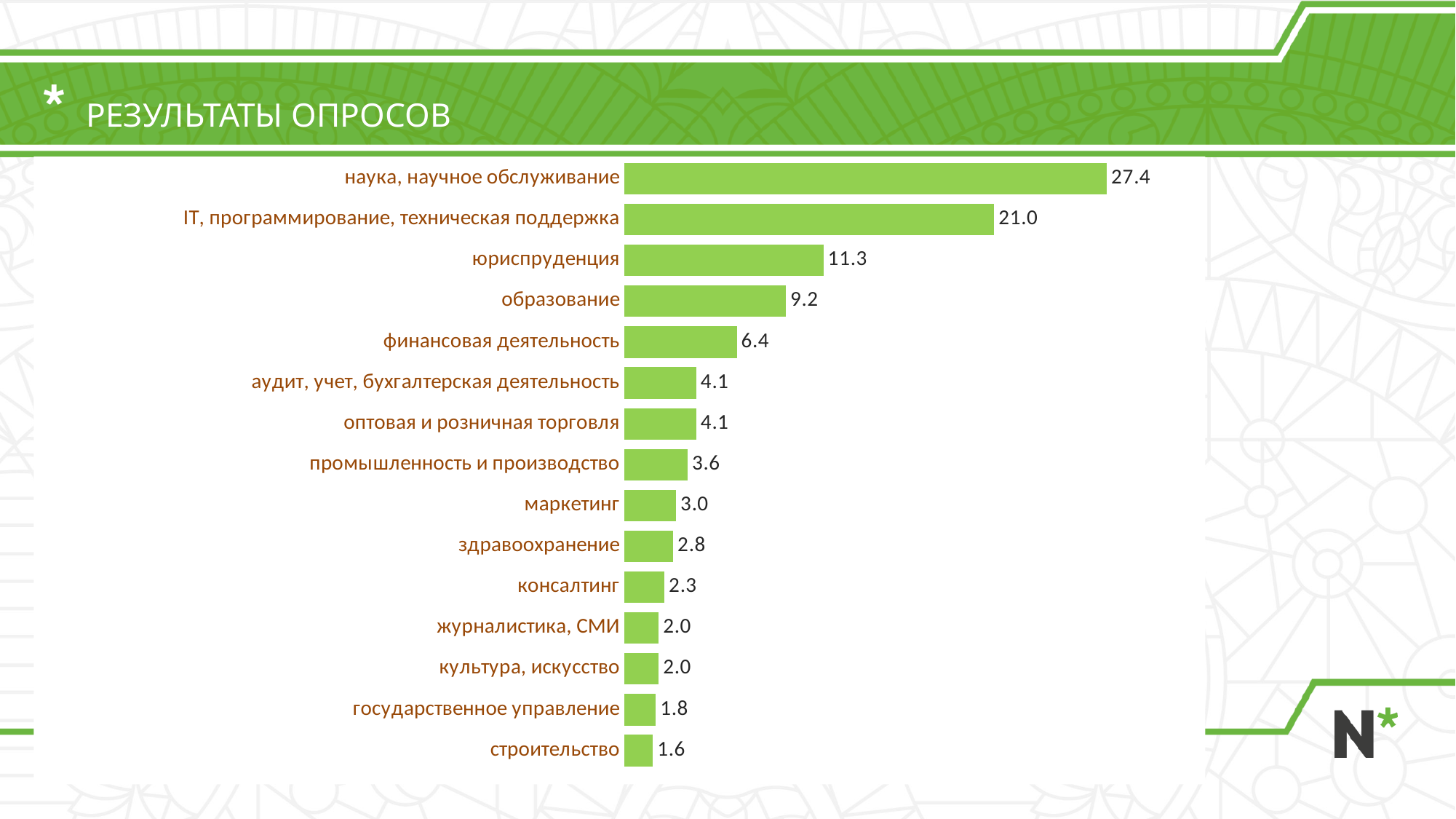
What value is shown for "образование"? 9.2 Which is larger, the value for "консалтинг" or the value for "промышленность и производство"? промышленность и производство What value is shown for "IT, программирование, техническая поддержка"? 21.0 What is the difference between the values for "наука, научное обслуживание" and "IT, программирование, техническая поддержка"? 6.4 What value is shown for "здравоохранение"? 2.8 What kind of chart is shown on the slide? bar chart Which category has the highest value? наука, научное обслуживание Which category has the lowest value? строительство How many categories are shown in the chart? 15 What is the title of the slide? РЕЗУЛЬТАТЫ ОПРОСОВ What is the difference between the values for "финансовая деятельность" and "маркетинг"? 3.4 What value is shown for "юриспруденция"? 11.3